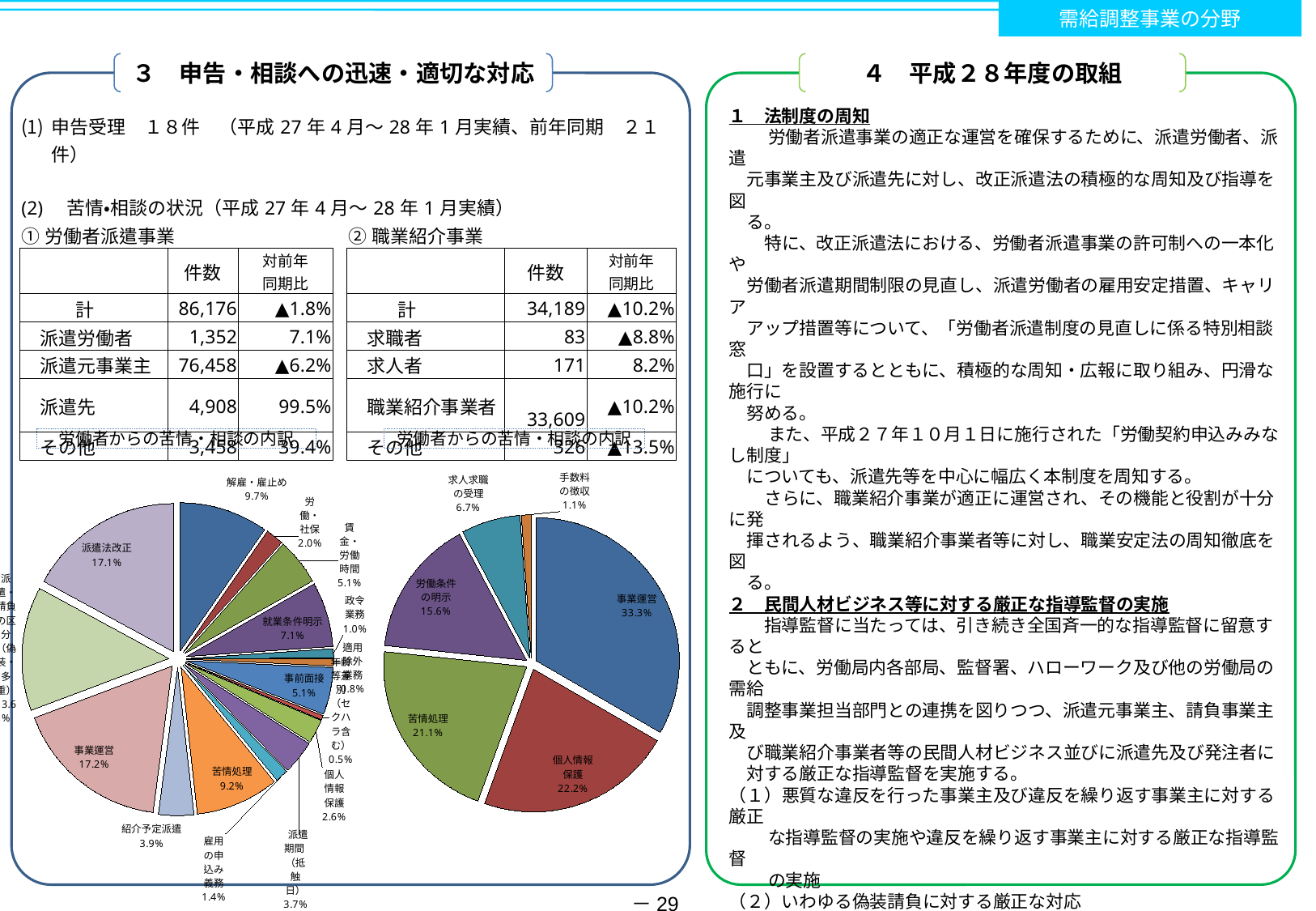
In the right pie chart (under ② 職業紹介事業), which category has the largest share? 事業運営 In the right pie chart (under ② 職業紹介事業), what is the difference in percentage points between 事業運営 and 個人情報保護? 11.1 In the right pie chart (under ② 職業紹介事業), how many slices are there? 6 In the right pie chart (under ② 職業紹介事業), what is the share for 個人情報保護? 22.2% In the right pie chart (under ② 職業紹介事業), which is larger: 労働条件の明示 or 求人求職の受理? 労働条件の明示 In the left pie chart (under ① 労働者派遣事業), what is the share for 派遣法改正? 17.1% What kind of chart is the left chart (労働者からの苦情・相談の内訳 under ① 労働者派遣事業)? pie chart In the right pie chart (労働者からの苦情・相談の内訳 under ② 職業紹介事業), what is the share for 事業運営? 33.3% In the right pie chart (under ② 職業紹介事業), which category has the smallest share? 手数料の徴収 In the right pie chart (under ② 職業紹介事業), what is the share for 労働条件の明示? 15.6% In the left pie chart (under ① 労働者派遣事業), which is larger: 苦情処理 or 紹介予定派遣? 苦情処理 In the left pie chart (under ① 労働者派遣事業), what is the share for 解雇・雇止め? 9.7%